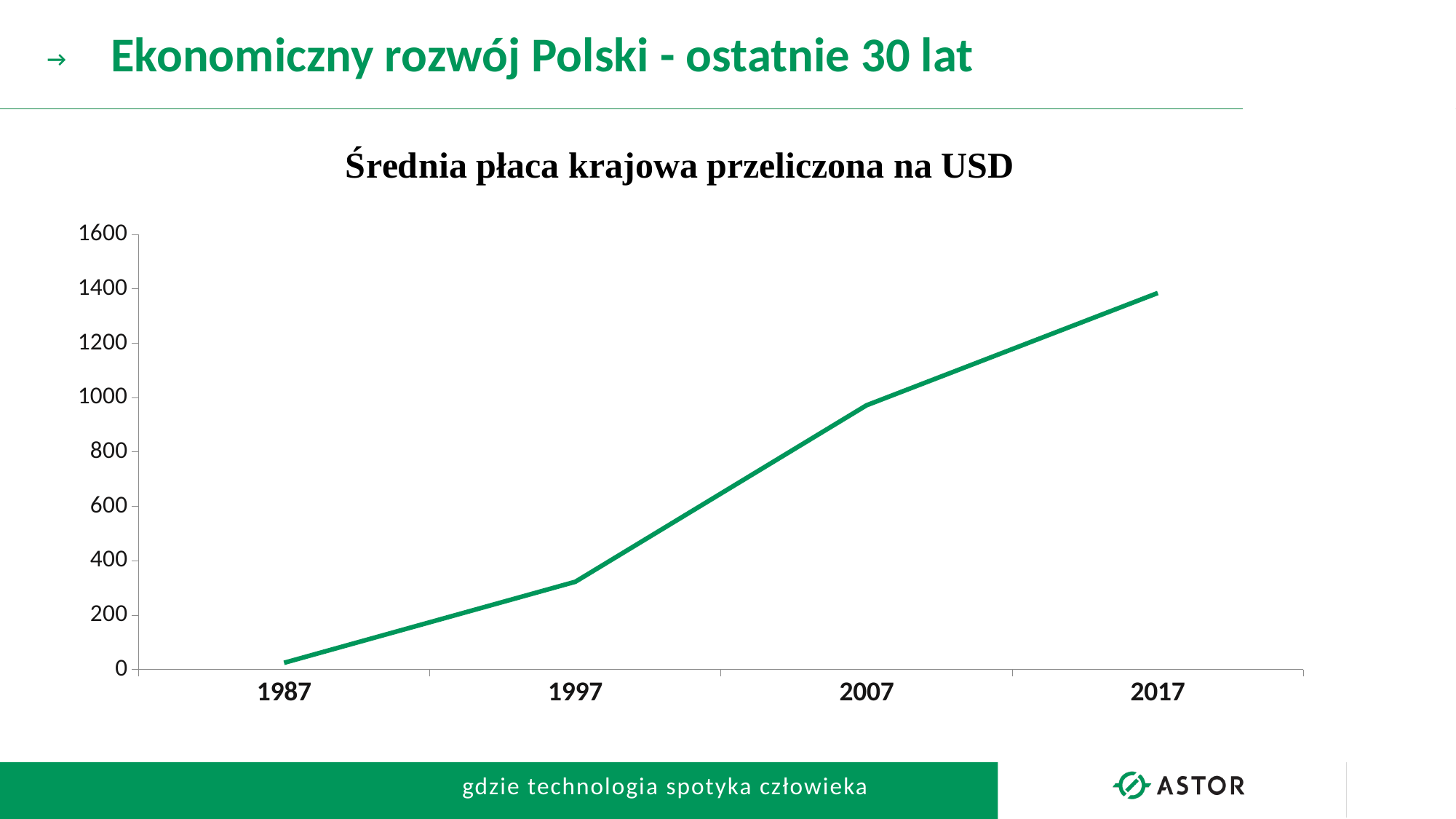
Which is larger, the value for 2007 or the value for 1997? 2007 What kind of chart is shown on the slide? line chart Do the values rise or fall from 1987 to 2017? rise Is the value for 2017 greater or less than 1200? greater Is the value for 2007 greater or less than 800? greater Which year has the highest value on the chart? 2017 What is the title of the chart? Średnia płaca krajowa przeliczona na USD Is the value for 1997 greater or less than 200? greater How many years are labelled on the x axis of the chart? 4 Which year has the lowest value on the chart? 1987